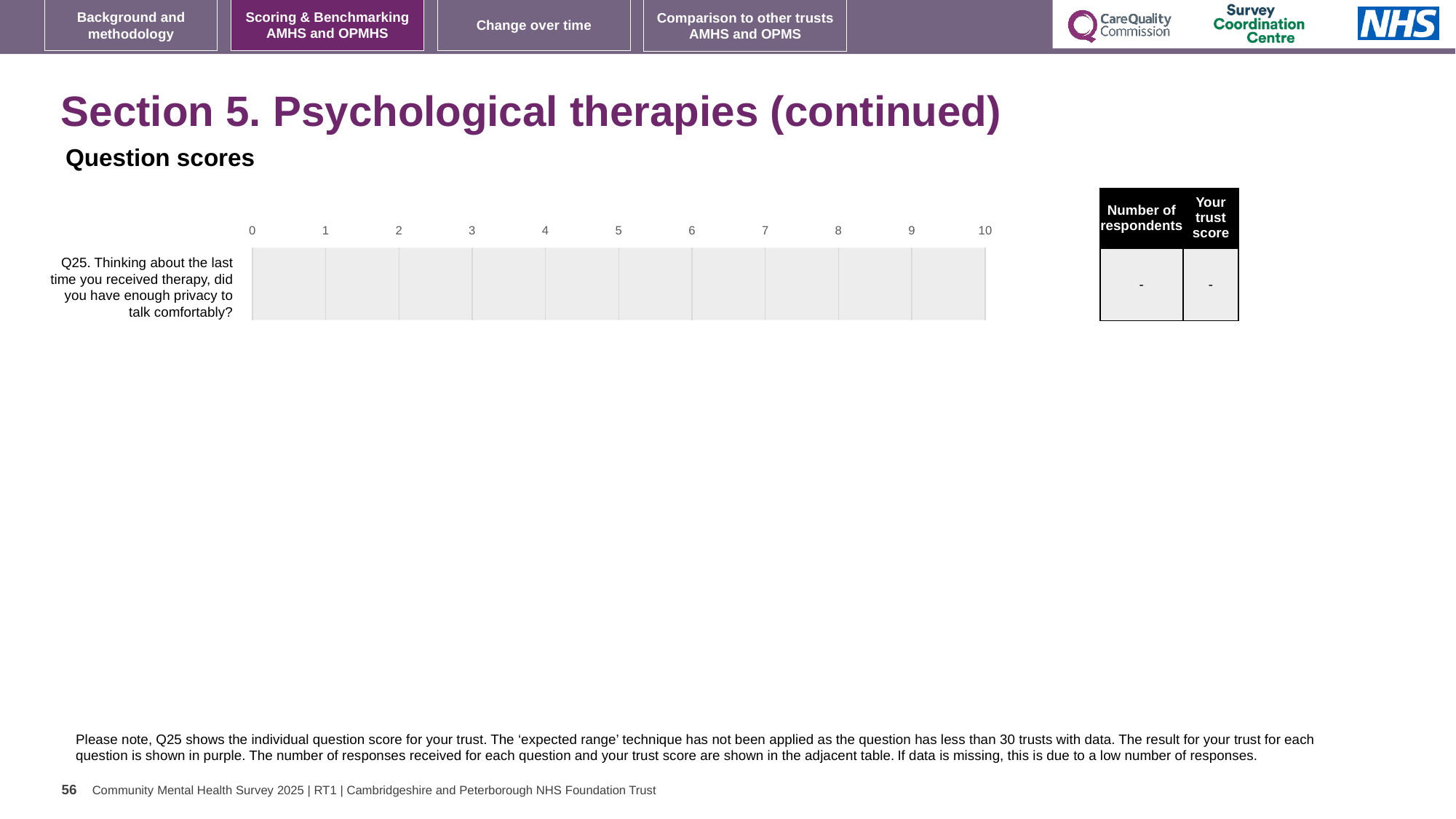
Which question number is shown on the chart? Q25 What is the trust score shown in the table for Q25? - Is a bar plotted for Q25 on the chart? No What is the number of respondents shown in the table for Q25? - What is the highest value shown on the chart's horizontal axis? 10 What is the lowest value shown on the chart's horizontal axis? 0 How many questions (categories) are listed on the chart's vertical axis? 1